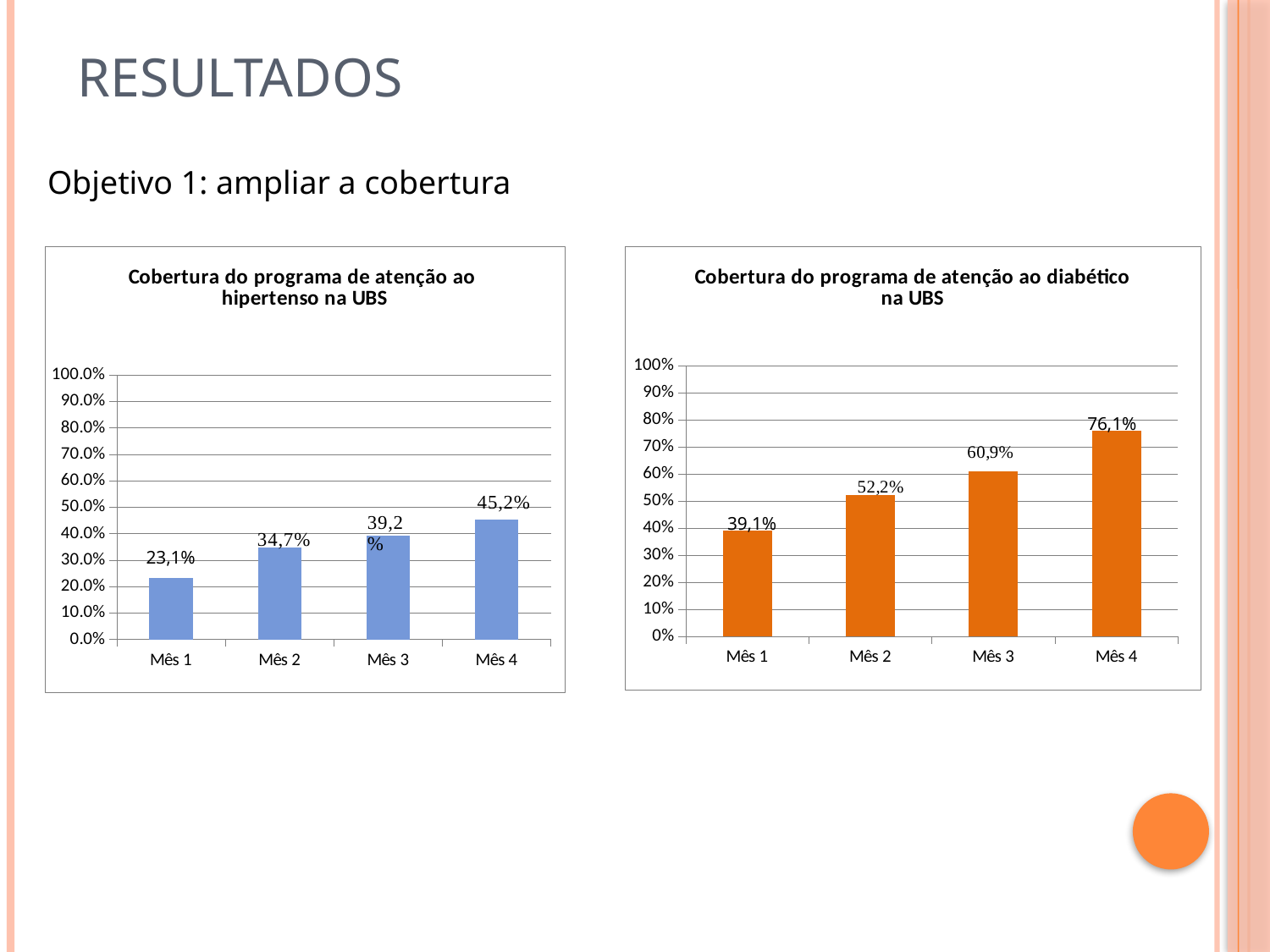
In the chart titled 'Cobertura do programa de atenção ao diabético na UBS', what is the difference between the values for Mês 4 and Mês 1? 37,0 percentage points In the chart titled 'Cobertura do programa de atenção ao diabético na UBS', what is the value for Mês 2? 52,2% Which is larger: the Mês 3 value in the hipertenso chart or the Mês 3 value in the diabético chart? The diabético chart (60,9%) In the chart titled 'Cobertura do programa de atenção ao hipertenso na UBS', what is the value for Mês 1? 23,1% In the chart titled 'Cobertura do programa de atenção ao hipertenso na UBS', which month has the lowest value? Mês 1 In the chart titled 'Cobertura do programa de atenção ao diabético na UBS', how many months are plotted? 4 In the chart titled 'Cobertura do programa de atenção ao diabético na UBS', which month has the highest value? Mês 4 In the chart titled 'Cobertura do programa de atenção ao diabético na UBS', do the values rise or fall from Mês 1 to Mês 4? Rise In the chart titled 'Cobertura do programa de atenção ao diabético na UBS', what is the value for Mês 3? 60,9% What type of chart is 'Cobertura do programa de atenção ao hipertenso na UBS'? Bar chart In the chart titled 'Cobertura do programa de atenção ao hipertenso na UBS', what is the value for Mês 4? 45,2% In the chart titled 'Cobertura do programa de atenção ao hipertenso na UBS', what is the difference between the values for Mês 4 and Mês 1? 22,1 percentage points